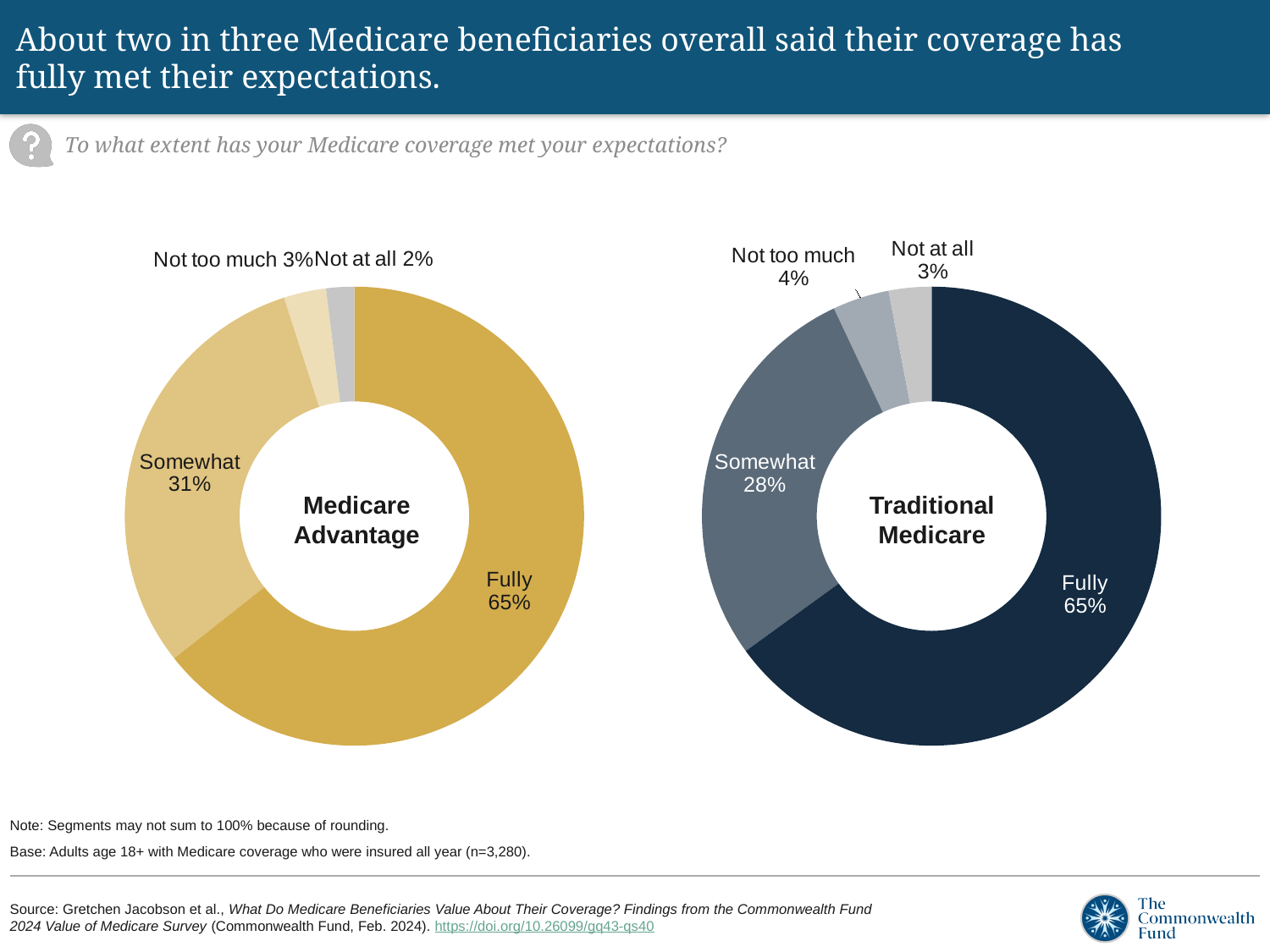
In the Traditional Medicare chart, which response has the smallest share? Not at all In the Medicare Advantage chart, which response has the largest share? Fully In the Medicare Advantage chart, what percentage answered 'Not at all'? 2% What label appears in the center of the left chart? Medicare Advantage In the Medicare Advantage chart, what percentage said their coverage fully met their expectations? 65% What is the difference between the 'Not at all' shares in the Traditional Medicare and Medicare Advantage charts? 1 percentage point In the Traditional Medicare chart, what percentage said their coverage somewhat met their expectations? 28% What type of chart is used on this slide? Donut (pie) chart How many segments does the Traditional Medicare chart have? 4 In the Medicare Advantage chart, what is the difference between the 'Fully' and 'Somewhat' shares? 34 percentage points Which chart shows a larger 'Somewhat' share, Medicare Advantage or Traditional Medicare? Medicare Advantage In the Traditional Medicare chart, what percentage answered 'Not too much'? 4%